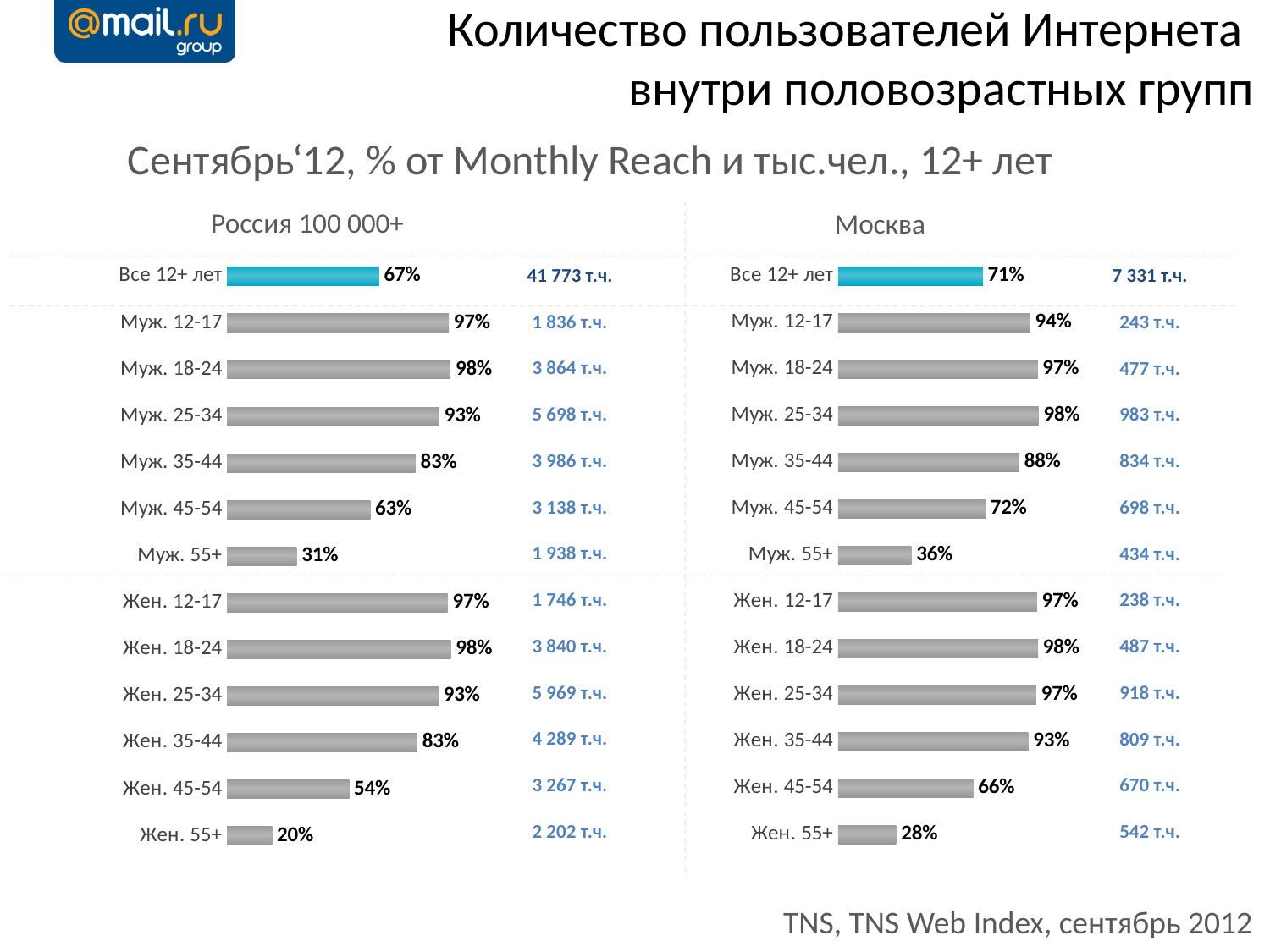
In the 'Россия 100 000+' chart, what is the difference between Муж. 55+ and Жен. 55+? 11% In the 'Москва' chart, which is larger: Муж. 35-44 or Жен. 35-44? Жен. 35-44 How many categories are shown in the 'Москва' chart? 13 In the 'Россия 100 000+' chart, which is larger: Муж. 45-54 or Жен. 45-54? Муж. 45-54 In the 'Москва' chart, what is the value for Жен. 35-44? 93% In the 'Москва' chart, what is the difference between Муж. 45-54 and Жен. 45-54? 6% In the 'Москва' chart, which category has the lowest value? Жен. 55+ In the 'Россия 100 000+' chart, what is the value for Все 12+ лет? 67% In the 'Москва' chart, what is the value for Все 12+ лет? 71% In the 'Россия 100 000+' chart, which category has the lowest value? Жен. 55+ In the 'Россия 100 000+' chart, what is the value for Муж. 45-54? 63% What type of chart is the 'Россия 100 000+' chart? Bar chart